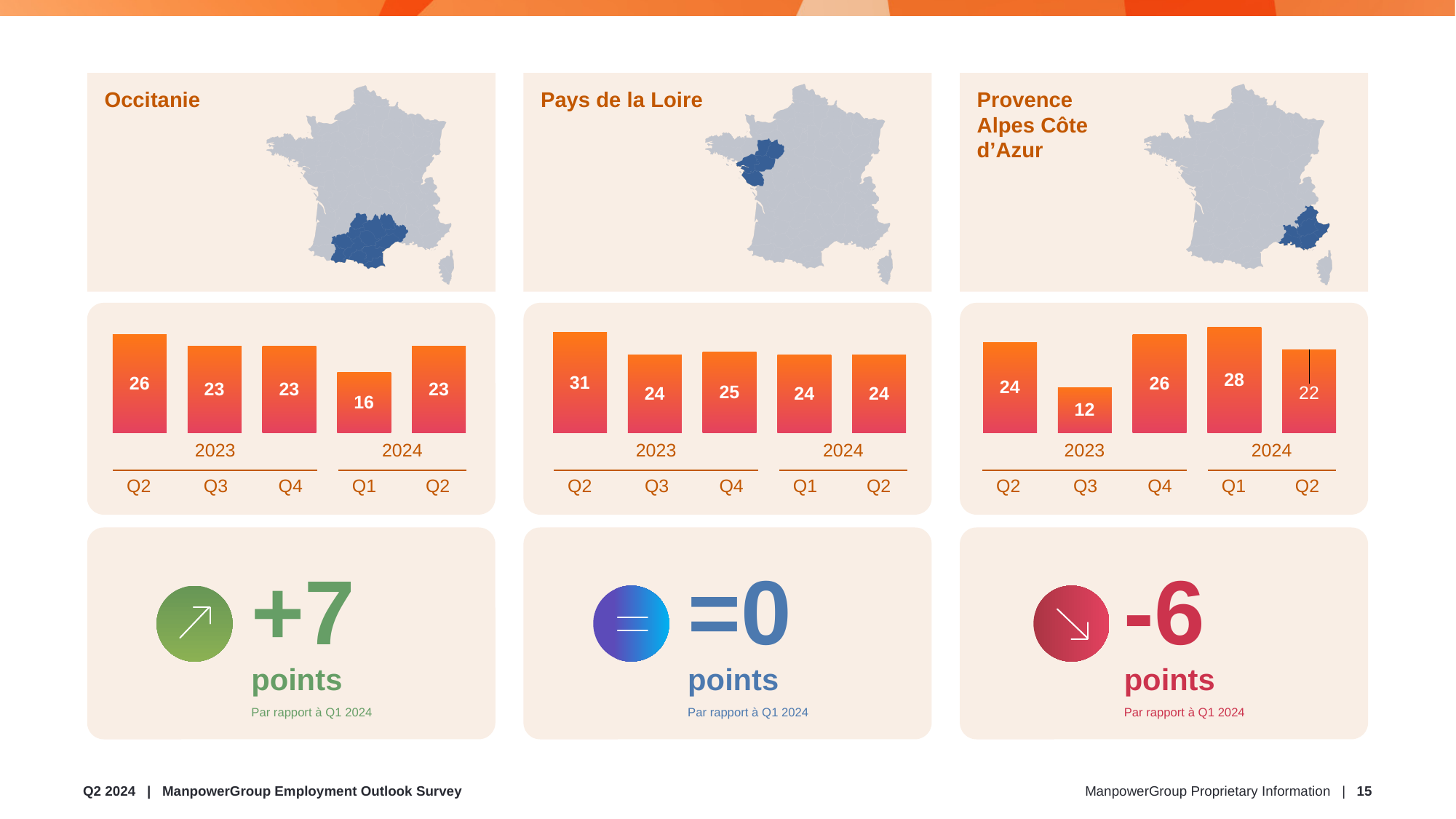
In the Occitanie chart, what is the value for Q1 2024? 16 How many bars are shown in the Occitanie chart? 5 In the Pays de la Loire chart, which quarter has the highest value? Q2 2023 In the Provence Alpes Côte d'Azur chart, what is the value for Q2 2024? 22 In the Provence Alpes Côte d'Azur chart, what is the value for Q3 2023? 12 In the Pays de la Loire chart, is the value for Q4 2023 larger or smaller than the value for Q3 2023? larger What type of chart is used for Pays de la Loire? bar chart In the Pays de la Loire chart, what is the value for Q2 2023? 31 In the Provence Alpes Côte d'Azur chart, which quarter has the lowest value? Q3 2023 In the Occitanie chart, what is the difference between the Q2 2024 value and the Q1 2024 value? 7 In the Provence Alpes Côte d'Azur chart, what is the difference between the Q1 2024 value and the Q2 2024 value? 6 In the Occitanie chart, which quarter has the highest value? Q2 2023